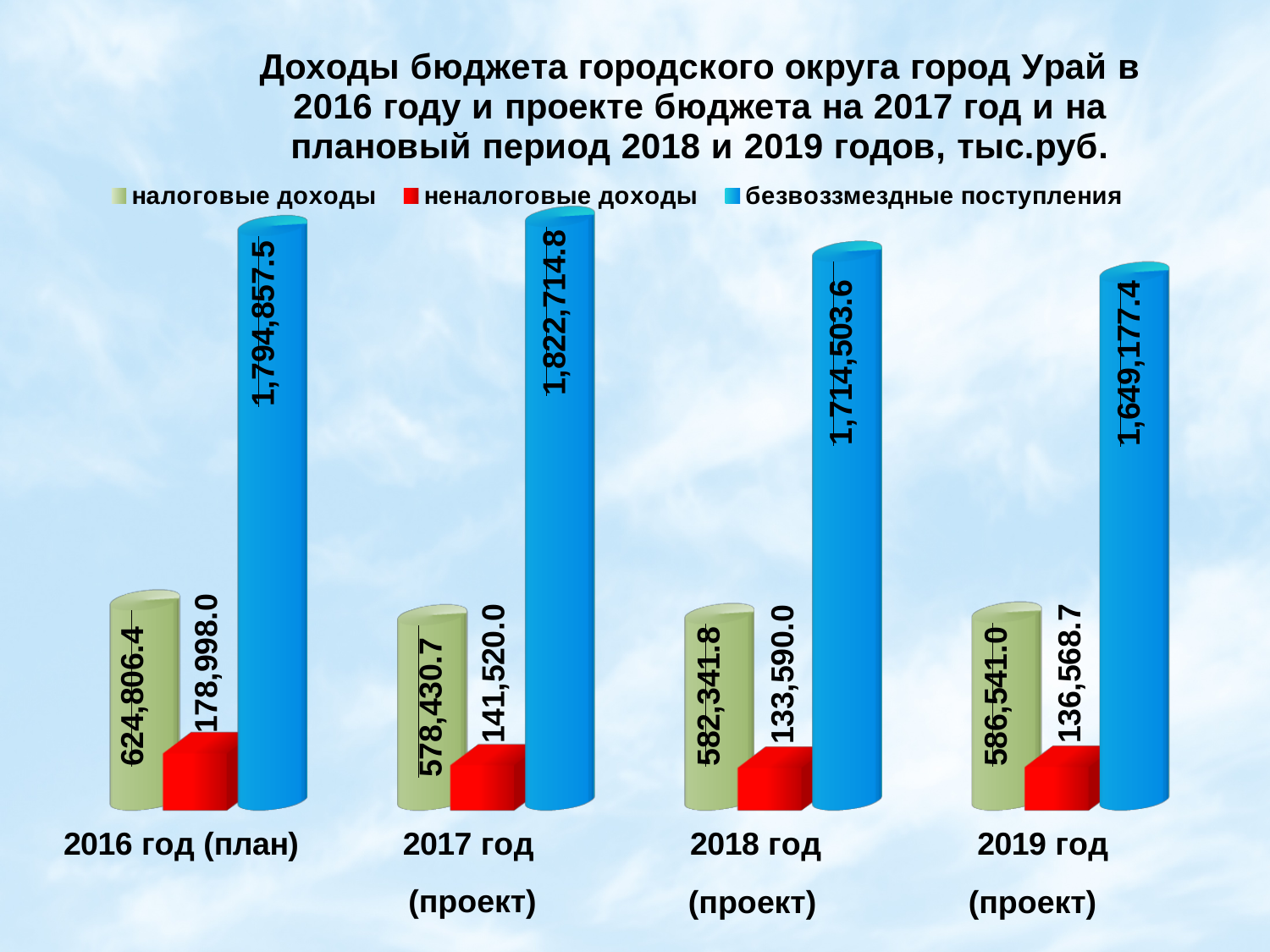
What is the value of безвозмездные поступления for 2016 год (план)? 1,794,857.5 How many year categories are shown on the chart? 4 In which year are налоговые доходы the highest? 2016 год (план) What is the difference between неналоговые доходы in 2016 год (план) and 2017 год (проект)? 37,478.0 What is the value of налоговые доходы for 2019 год (проект)? 586,541.0 How many series does the legend list? 3 In which year are безвозмездные поступления the highest? 2017 год (проект) What is the value of неналоговые доходы for 2018 год (проект)? 133,590.0 What is the difference between безвозмездные поступления in 2017 год (проект) and 2016 год (план)? 27,857.3 In which year are неналоговые доходы the lowest? 2018 год (проект) Which is larger: налоговые доходы in 2018 год (проект) or in 2019 год (проект)? 2019 год (проект) Do безвозмездные поступления rise or fall from 2017 год (проект) to 2019 год (проект)? fall